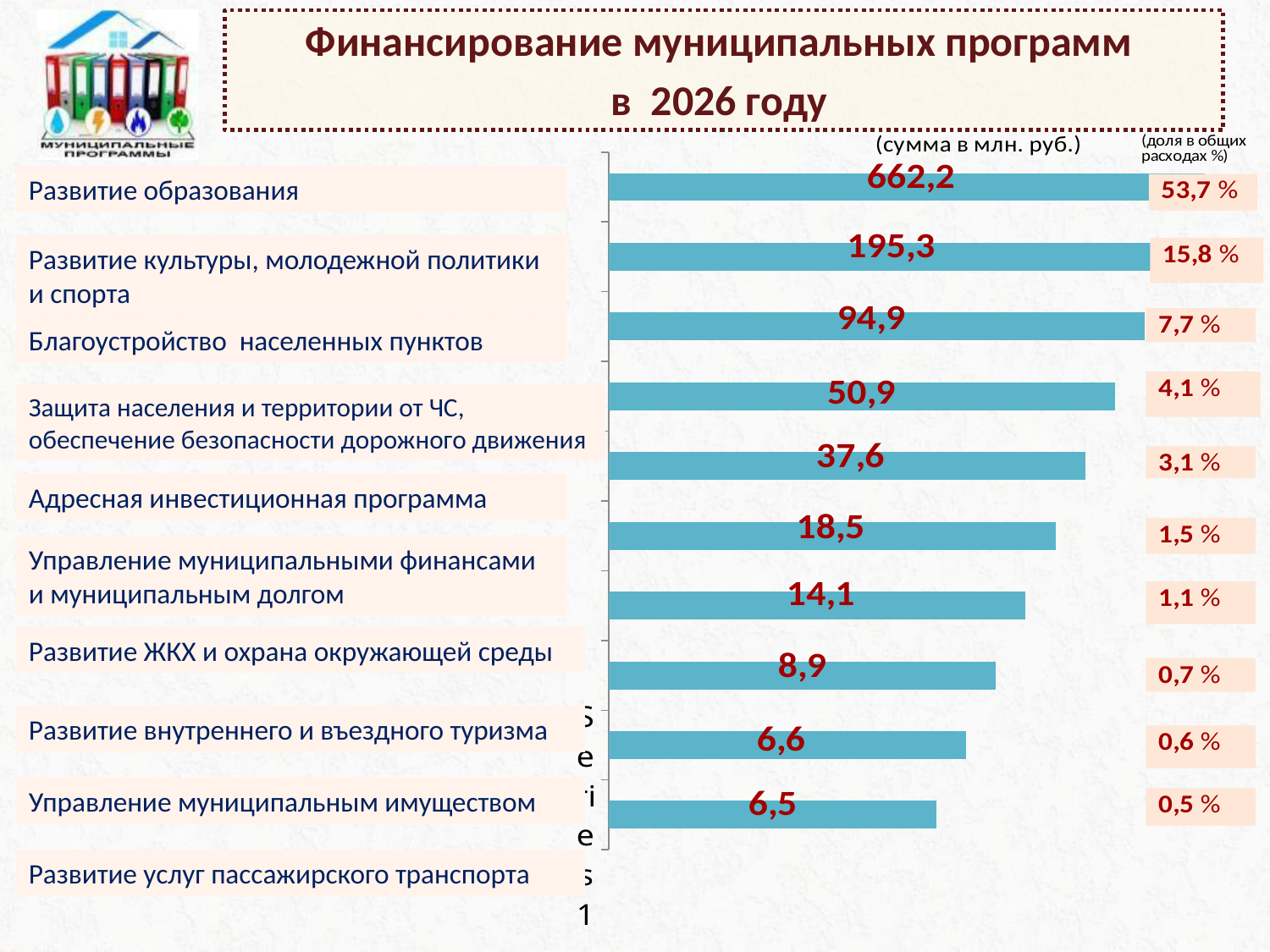
Do the funding amounts increase or decrease going from the top bar to the bottom bar? decrease What is the funding amount (млн руб.) for «Развитие образования»? 662,2 Which has more funding: «Развитие ЖКХ и охрана окружающей среды» or «Управление муниципальными финансами и муниципальным долгом»? Управление муниципальными финансами и муниципальным долгом What share of total expenditures does «Развитие услуг пассажирского транспорта» have? 0,5 % Which program receives the smallest funding? Развитие услуг пассажирского транспорта What kind of chart is shown on the slide? bar chart What is the funding amount (млн руб.) for «Благоустройство населенных пунктов»? 94,9 What share of total expenditures does «Развитие культуры, молодежной политики и спорта» have? 15,8 % What is the funding amount (млн руб.) for «Адресная инвестиционная программа»? 37,6 Which program receives the largest funding? Развитие образования How many municipal programs (bars) are shown in the chart? 10 What is the difference in funding (млн руб.) between «Развитие образования» and «Развитие культуры, молодежной политики и спорта»? 466,9